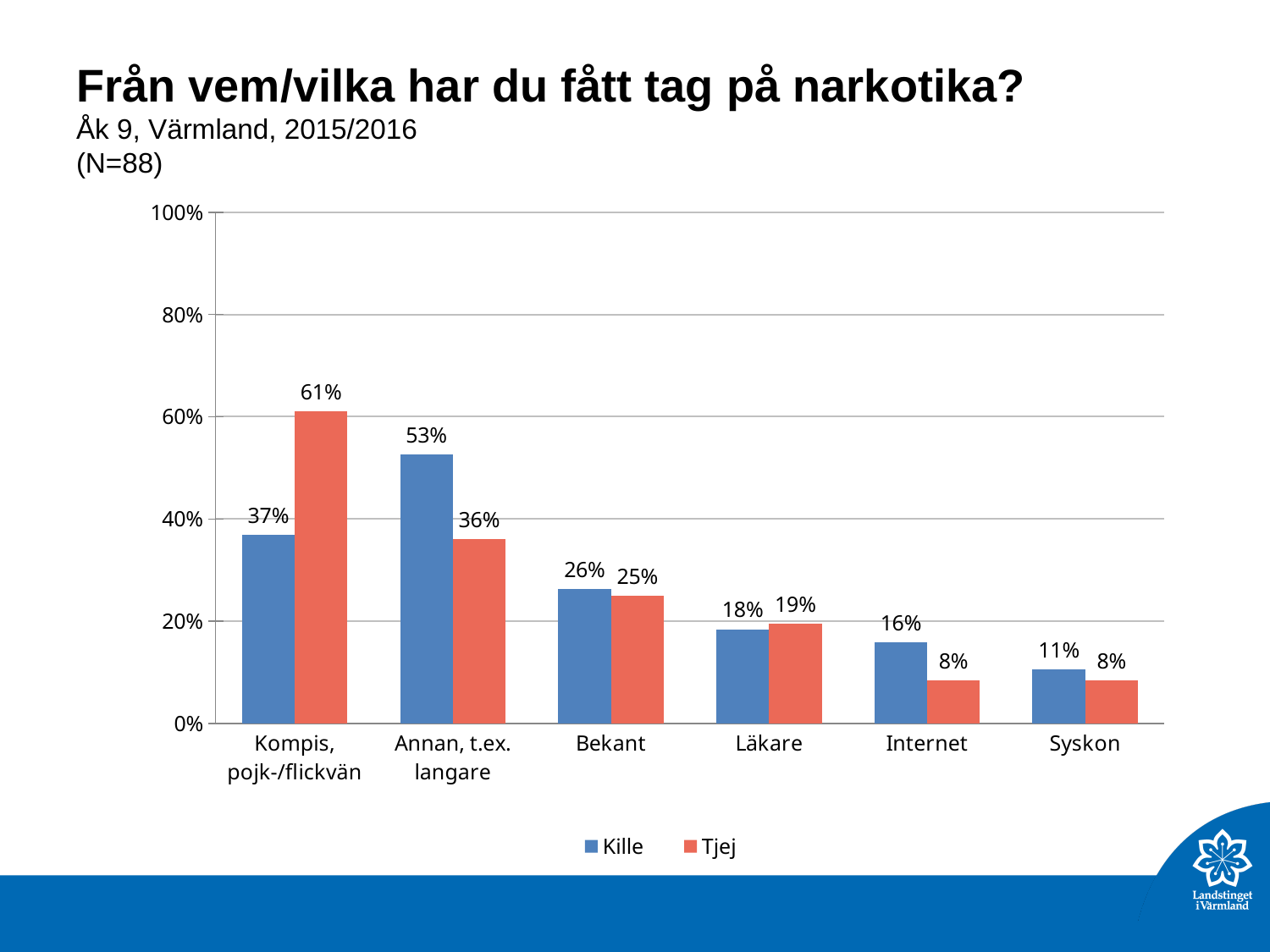
Which category has the lowest value for the Kille series? Syskon What kind of chart is shown on the slide? Bar chart What is the value for Kille in the Internet category? 16% What is the value for Tjej in the Kompis, pojk-/flickvän category? 61% How many categories are shown on the x axis? 6 Which series has the larger value in the Annan, t.ex. langare category, Kille or Tjej? Kille What is the difference between the Kille and Tjej values in the Kompis, pojk-/flickvän category? 24% What colour are the bars for the Tjej series? Red/orange Is the value for Kille in the Bekant category greater or less than 20%? greater What is the value for Kille in the Annan, t.ex. langare category? 53% Which category has the highest value for the Tjej series? Kompis, pojk-/flickvän How many series does the legend list? 2